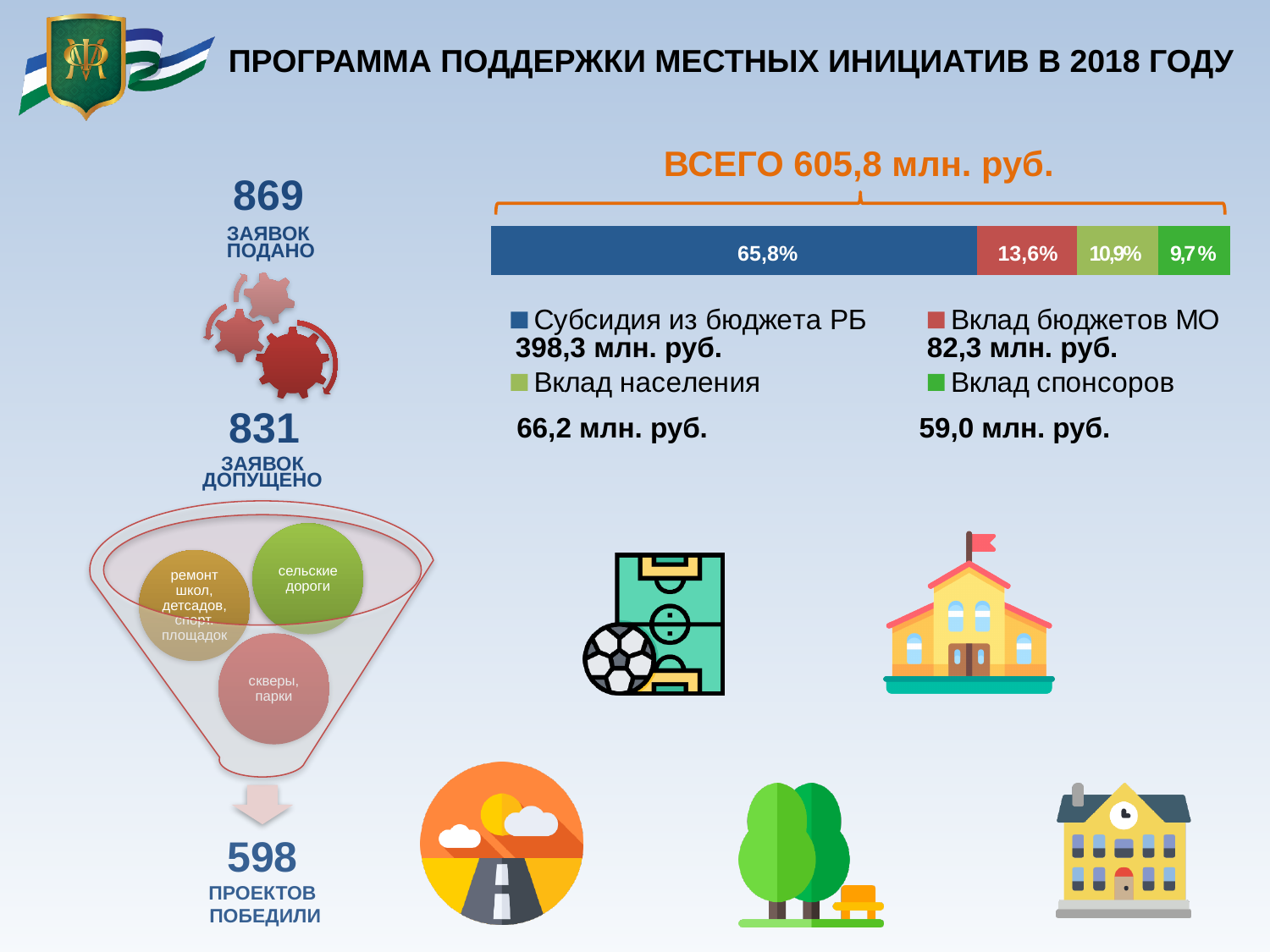
How many segments make up the stacked bar? 4 What percentage share does the segment for Субсидия из бюджета РБ show in the stacked bar? 65,8% What is the difference in percentage points between the Вклад бюджетов МО segment and the Вклад спонсоров segment? 3,9 What percentage share does the segment for Вклад бюджетов МО show in the stacked bar? 13,6% Which is larger: the share for Вклад населения or the share for Вклад спонсоров? Вклад населения How many series does the legend list? 4 Which funding source has the largest share in the stacked bar? Субсидия из бюджета РБ What percentage share does the segment for Вклад спонсоров show in the stacked bar? 9,7% What percentage share does the segment for Вклад населения show in the stacked bar? 10,9% What kind of chart is shown on the slide? Stacked bar chart Which funding source has the smallest share in the stacked bar? Вклад спонсоров What total amount in млн. руб. is shown above the stacked bar? 605,8 млн. руб.